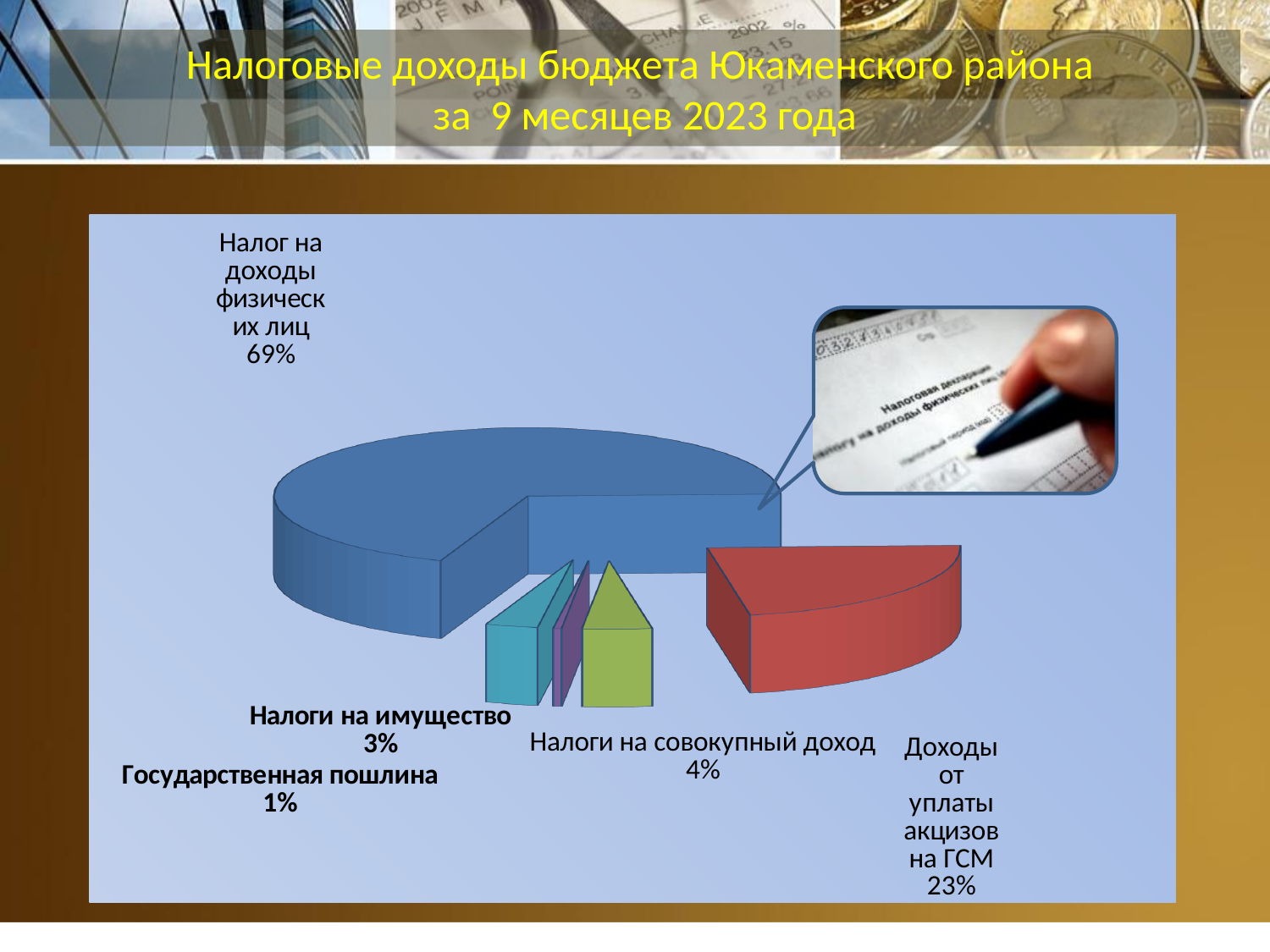
What is the title of the slide containing the chart? Налоговые доходы бюджета Юкаменского района за 9 месяцев 2023 года Which category has the smallest share of the pie? Государственная пошлина What is the value shown for "Налоги на совокупный доход"? 4% How many slices does the pie chart have? 5 What share of the pie does "Налог на доходы физических лиц" have? 69% Which category has the largest share of the pie? Налог на доходы физических лиц What is the value shown for "Налоги на имущество"? 3% What kind of chart is shown on the slide? Pie chart Which is larger: "Налоги на совокупный доход" or "Налоги на имущество"? Налоги на совокупный доход What share of the pie does "Доходы от уплаты акцизов на ГСМ" have? 23% What is the difference in percentage points between "Налог на доходы физических лиц" and "Доходы от уплаты акцизов на ГСМ"? 46 What is the value shown for "Государственная пошлина"? 1%